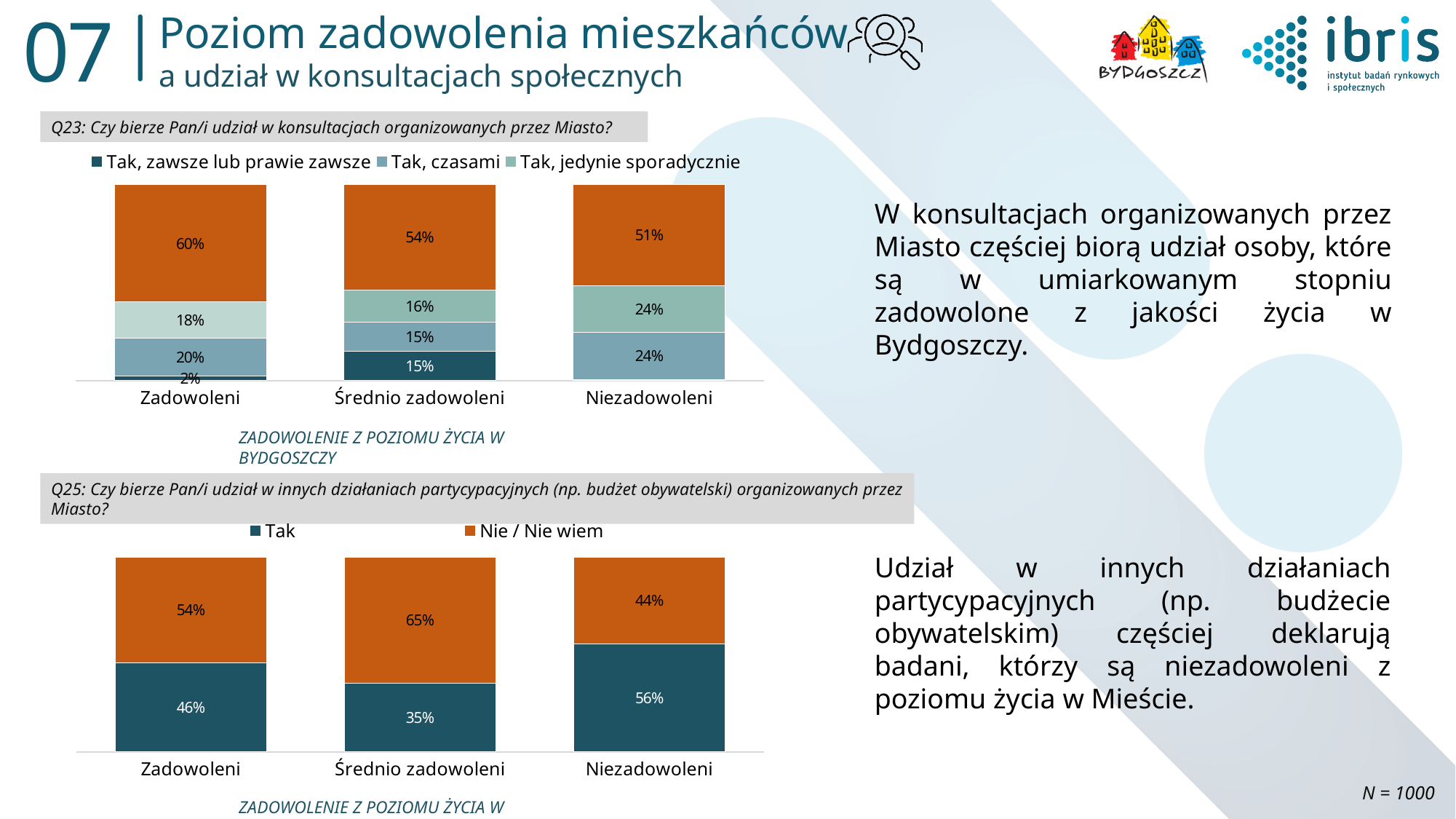
In the top chart (Q23), which category has the lowest value for 'Tak, zawsze lub prawie zawsze' among those with a printed label? Zadowoleni In the top chart (Q23), how many entries does the legend list? 3 In the bottom chart (Q25), what is the 'Nie / Nie wiem' value for Średnio zadowoleni? 65% In the bottom chart (Q25), which category has the highest 'Tak' value? Niezadowoleni In the bottom chart (Q25), which category has the lowest 'Tak' value? Średnio zadowoleni What type of chart is the bottom chart (Q25)? Stacked bar chart In the top chart (Q23), what is the value of the 'Tak, zawsze lub prawie zawsze' segment for Średnio zadowoleni? 15% In the bottom chart (Q25), how many categories are shown on the x axis? 3 In the bottom chart (Q25), what is the 'Tak' value for Niezadowoleni? 56% In the top chart (Q23), what is the value of the orange segment for Zadowoleni? 60% In the top chart (Q23), what is the value of the 'Tak, czasami' segment for Niezadowoleni? 24% In the bottom chart (Q25), what is the difference between the 'Tak' values for Niezadowoleni and Zadowoleni? 10%